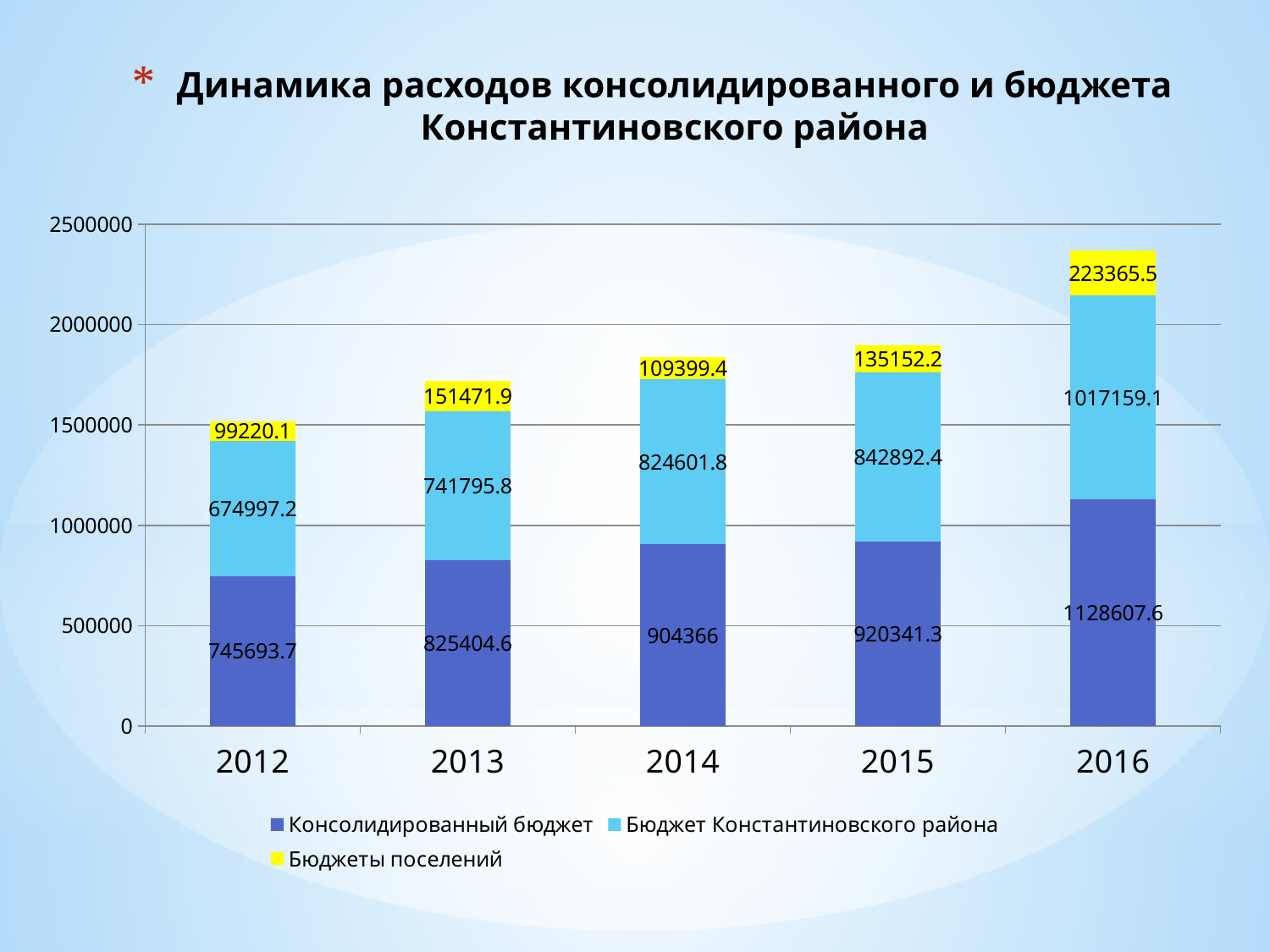
In which year is Консолидированный бюджет the highest? 2016 How many years are shown on the x axis? 5 In which year is Бюджеты поселений the lowest? 2012 What type of chart is shown on the slide? Stacked bar chart What is the difference between Консолидированный бюджет in 2016 and in 2015? 208266.3 What is the value of Бюджеты поселений for 2013? 151471.9 Which is larger: Бюджеты поселений in 2014 or in 2015? 2015 Does Консолидированный бюджет rise or fall from 2012 to 2016? Rise What is the total of the stacked bar for 2012? 1519911 How many series does the legend list? 3 What is the value of Бюджет Константиновского района for 2016? 1017159.1 What is the value of Консолидированный бюджет for 2014? 904366